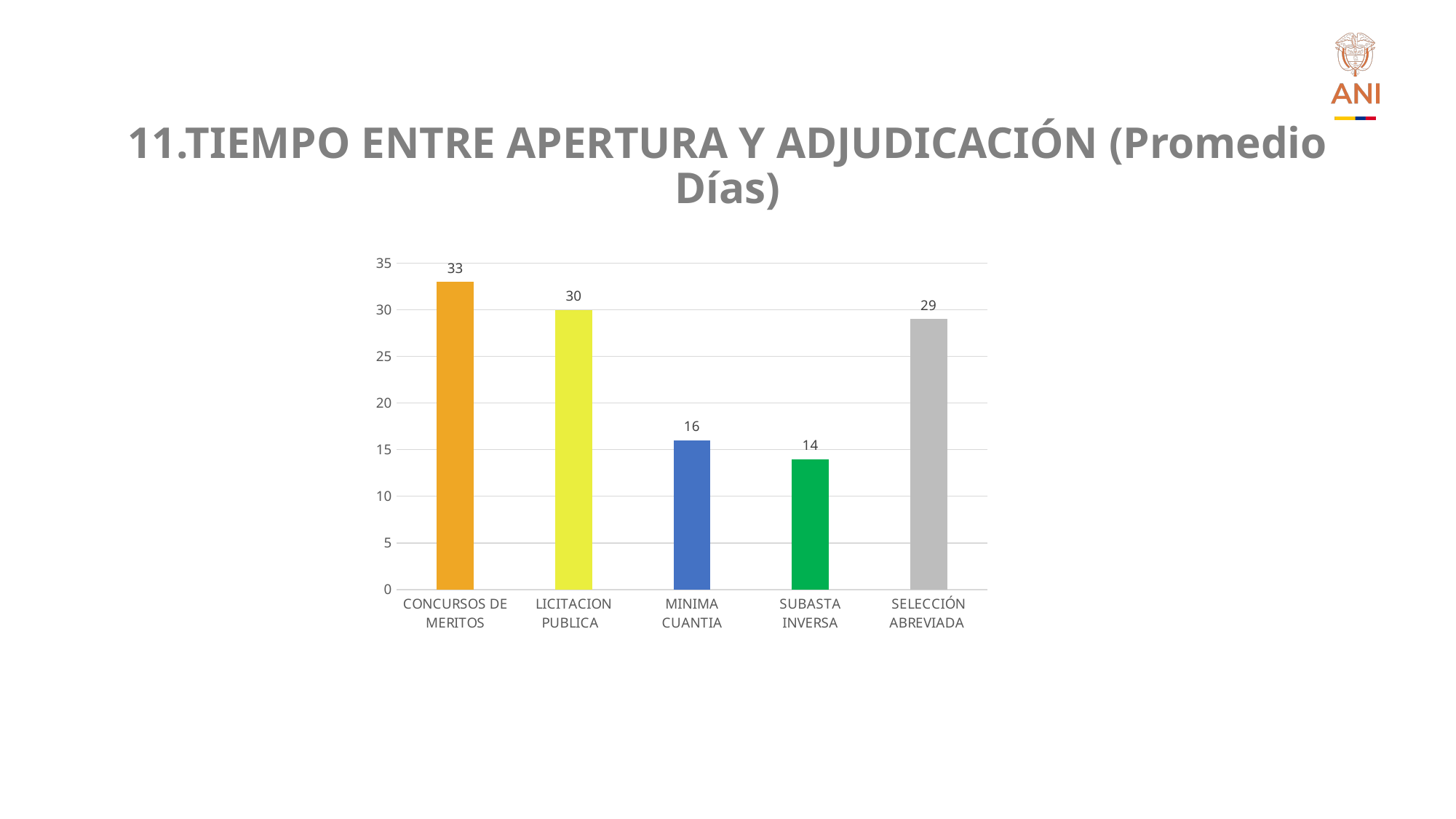
How many categories are shown in the chart? 5 Which is larger, the value for LICITACION PUBLICA or the value for SELECCIÓN ABREVIADA? LICITACION PUBLICA What is the value for SUBASTA INVERSA? 14 What is the value for LICITACION PUBLICA? 30 Which category has the lowest value? SUBASTA INVERSA What is the value for CONCURSOS DE MERITOS? 33 What is the difference between the values for CONCURSOS DE MERITOS and SUBASTA INVERSA? 19 What colour is the bar for SUBASTA INVERSA? Green What is the value for MINIMA CUANTIA? 16 Which category has the highest value? CONCURSOS DE MERITOS What is the value for SELECCIÓN ABREVIADA? 29 What kind of chart is shown on the slide? Bar chart